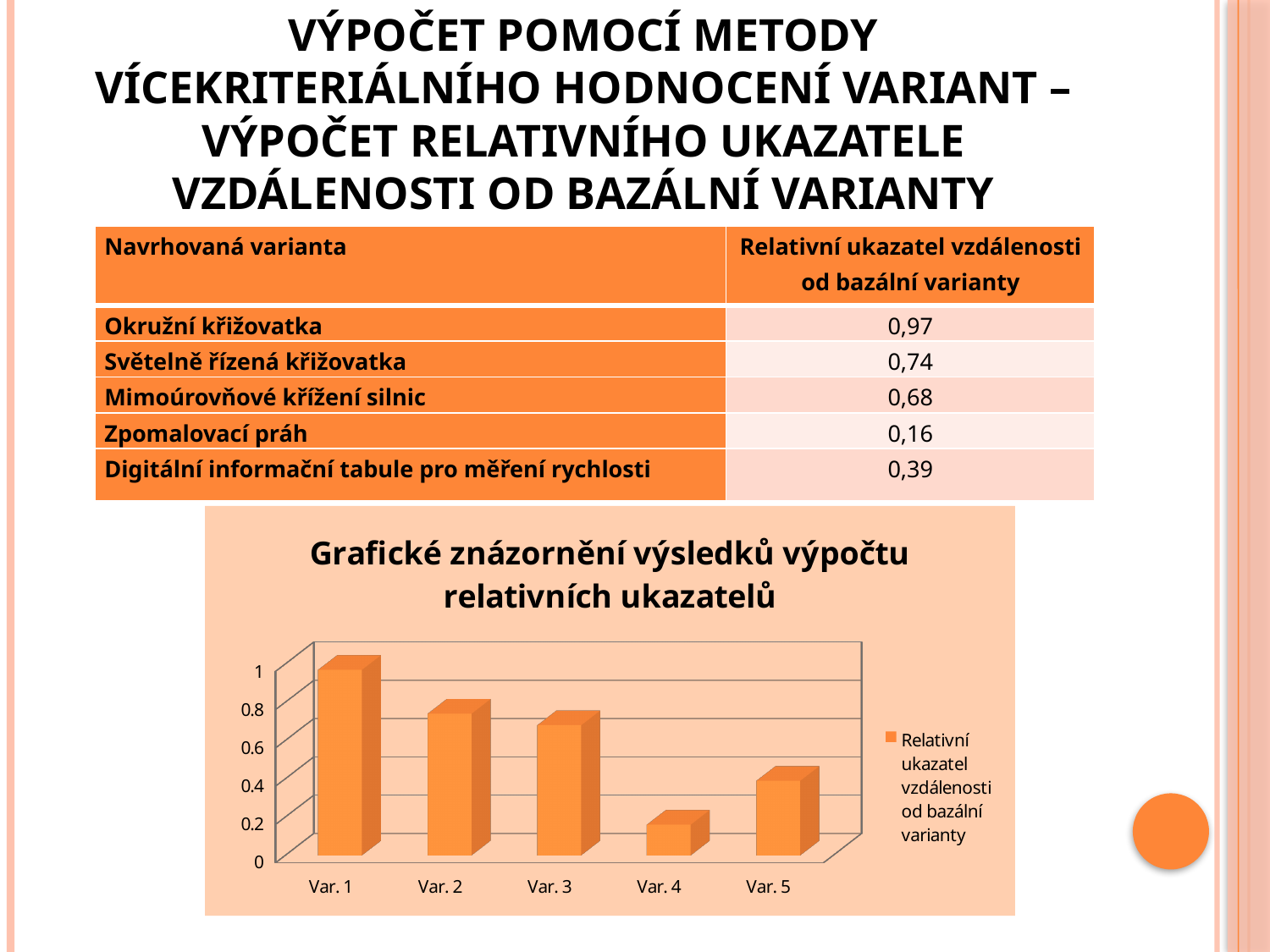
Is the value for Var. 3 greater or less than 0.6? greater How many categories are shown on the x axis of the chart? 5 Which category has the lowest bar in the chart? Var. 4 How many series does the chart legend list? 1 Is the value for Var. 5 greater or less than 0.2? greater Which category has the highest bar in the chart? Var. 1 What is the title of the chart? Grafické znázornění výsledků výpočtu relativních ukazatelů Which is larger, the value for Var. 4 or the value for Var. 5? Var. 5 Is the value for Var. 1 greater or less than 0.8? greater What kind of chart is shown on the slide? bar chart